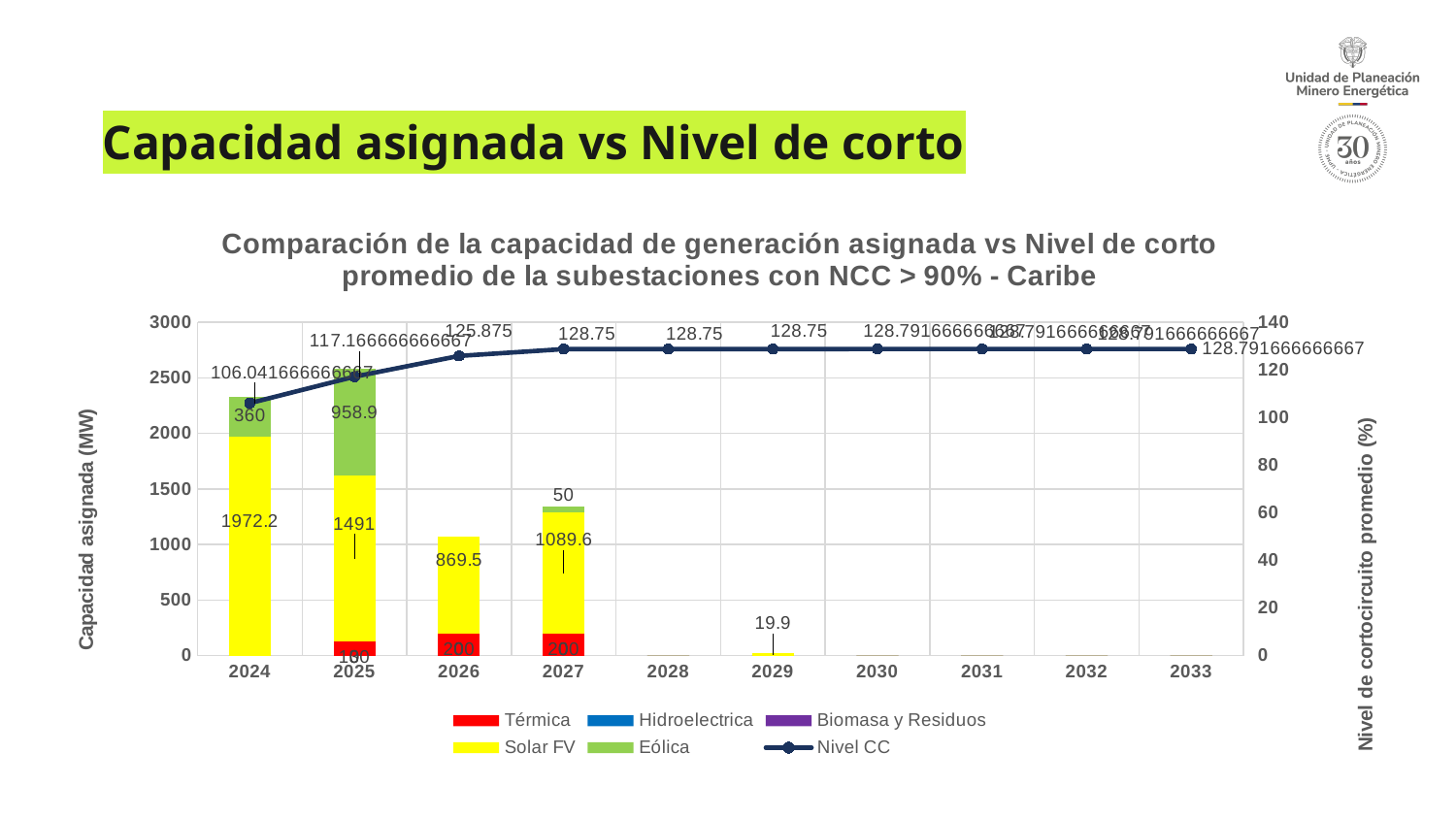
What is the Solar FV value for 2024? 1972.2 What is the Nivel CC value for 2026? 125.875 Which year has the highest Solar FV value? 2024 How many series does the legend list? 6 What is the total of the stacked bar for 2027? 1339.6 Does the Nivel CC line rise or fall from 2024 to 2033? rises Which year has the larger Eólica value, 2024 or 2025? 2025 How many years are shown on the x axis? 10 What is the total of the stacked bar for 2026? 1069.5 What is the Eólica value for 2025? 958.9 What is the Solar FV value for 2029? 19.9 What is the difference between the Solar FV values for 2024 and 2025? 481.2